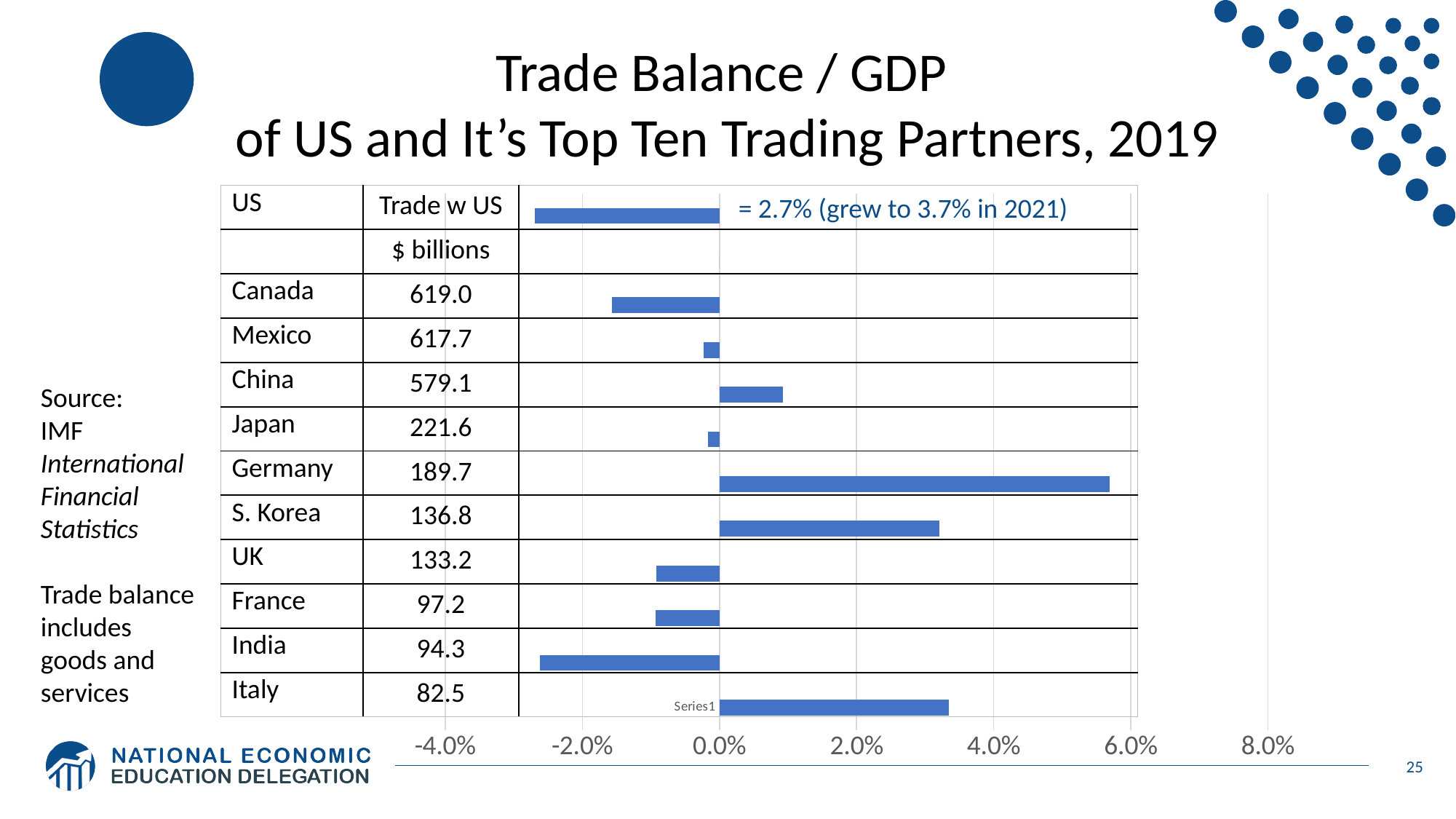
Which has the larger trade balance / GDP value, China or Germany? Germany Is the value for Canada greater or less than 0.0%? less Which country has the highest trade balance / GDP bar on the chart? Germany What is the highest value shown on the horizontal axis of the chart? 8.0% Is the value for S. Korea greater or less than 2.0%? greater Which has the larger trade balance / GDP value, Germany or S. Korea? Germany What kind of chart is shown on the slide? bar chart According to the annotation on the chart, what did the US trade balance / GDP grow to in 2021? 3.7% How many countries (including the US) have bars plotted on the chart? 11 Is the value for India greater or less than -2.0%? less